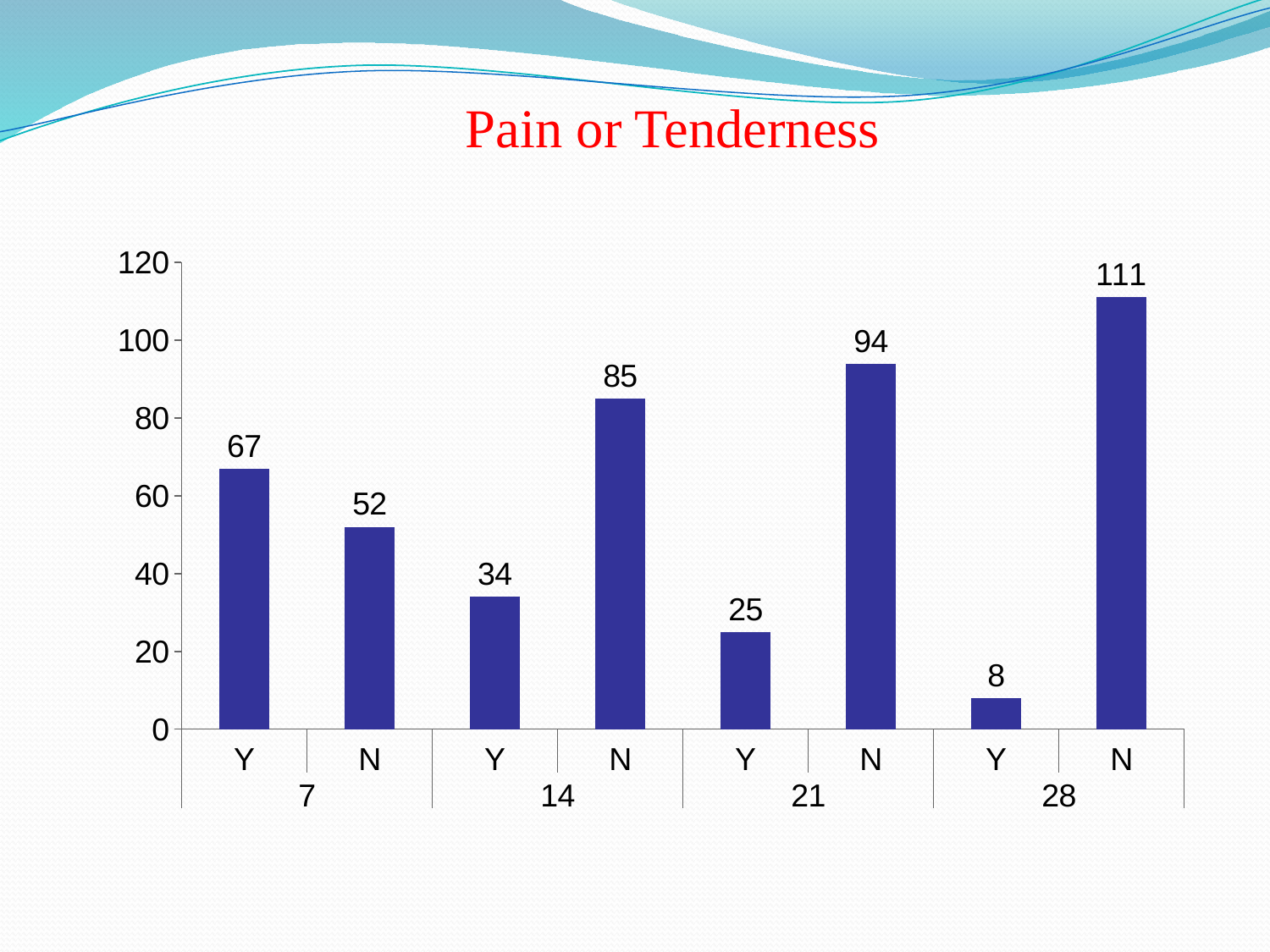
Which bar has the lowest value? Y in group 28 What is the title of the chart? Pain or Tenderness What is the value for N in group 14? 85 What is the difference between N in group 28 and N in group 7? 59 Which is larger in group 7, Y or N? Y Do the Y values rise or fall across groups 7, 14, 21 and 28? fall What kind of chart is shown? bar chart How many bars are plotted in the chart? 8 What is the value for Y in group 7? 67 What is the value for Y in group 28? 8 Which bar has the highest value? N in group 28 What is the difference between N and Y in group 21? 69